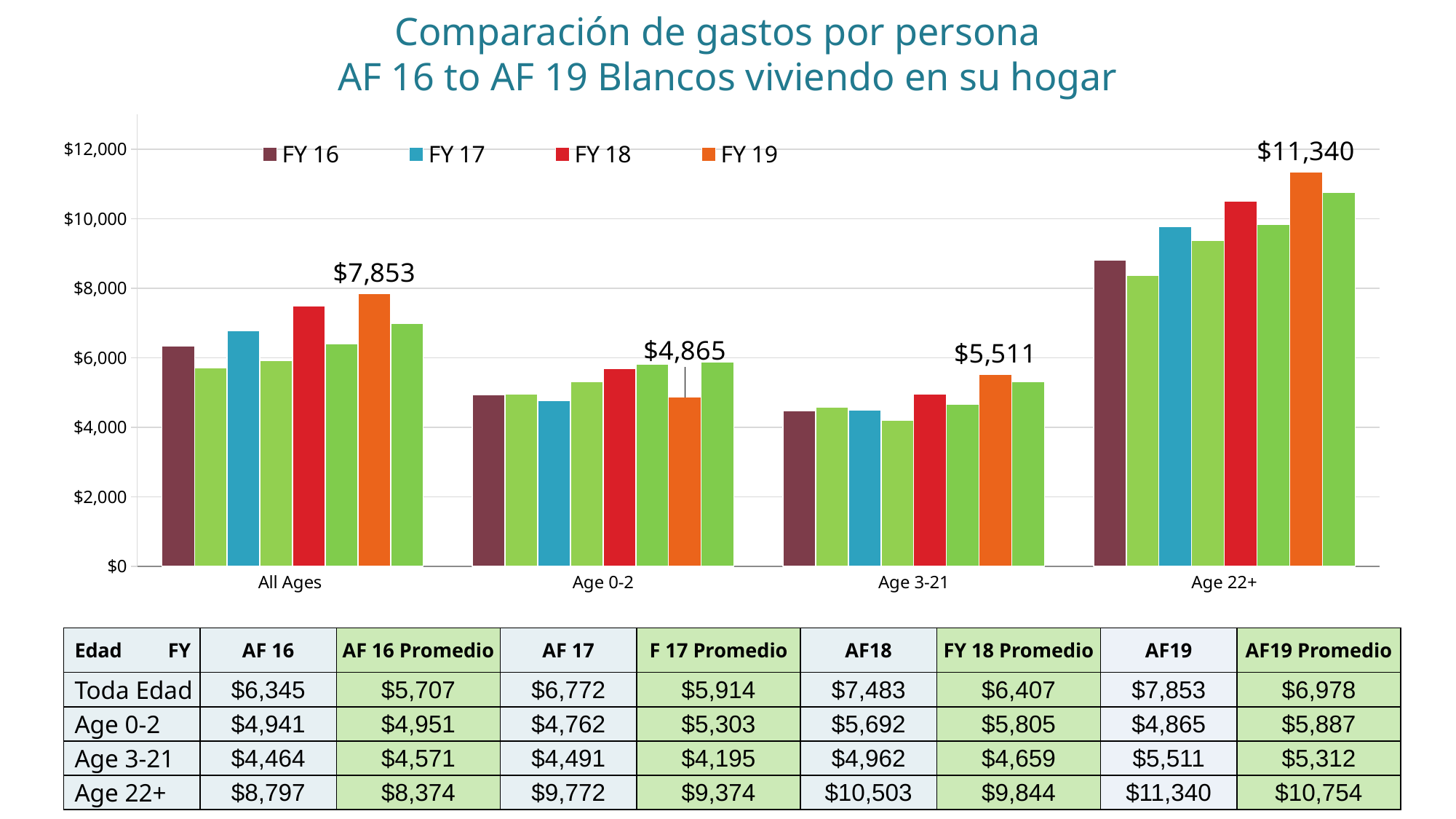
What is the FY 19 value for All Ages shown as a data label on the chart? $7,853 How many age categories are shown on the x axis of the chart? 4 What kind of chart is shown on the slide? bar chart Is the FY 19 value for Age 0-2 larger or smaller than the FY 19 value for Age 3-21? smaller Do the FY 19 values rise or fall from Age 0-2 to Age 22+ along the x axis? rise What is the difference between the FY 19 values for Age 22+ and All Ages? $3,487 Which age category has the lowest FY 19 value? Age 0-2 Which age category has the highest FY 19 value? Age 22+ How many series does the chart legend list? 4 What is the FY 19 value for Age 3-21 shown as a data label on the chart? $5,511 Is the FY 16 value for Age 22+ greater or less than $8,000? greater What is the FY 19 value for Age 22+ shown as a data label on the chart? $11,340